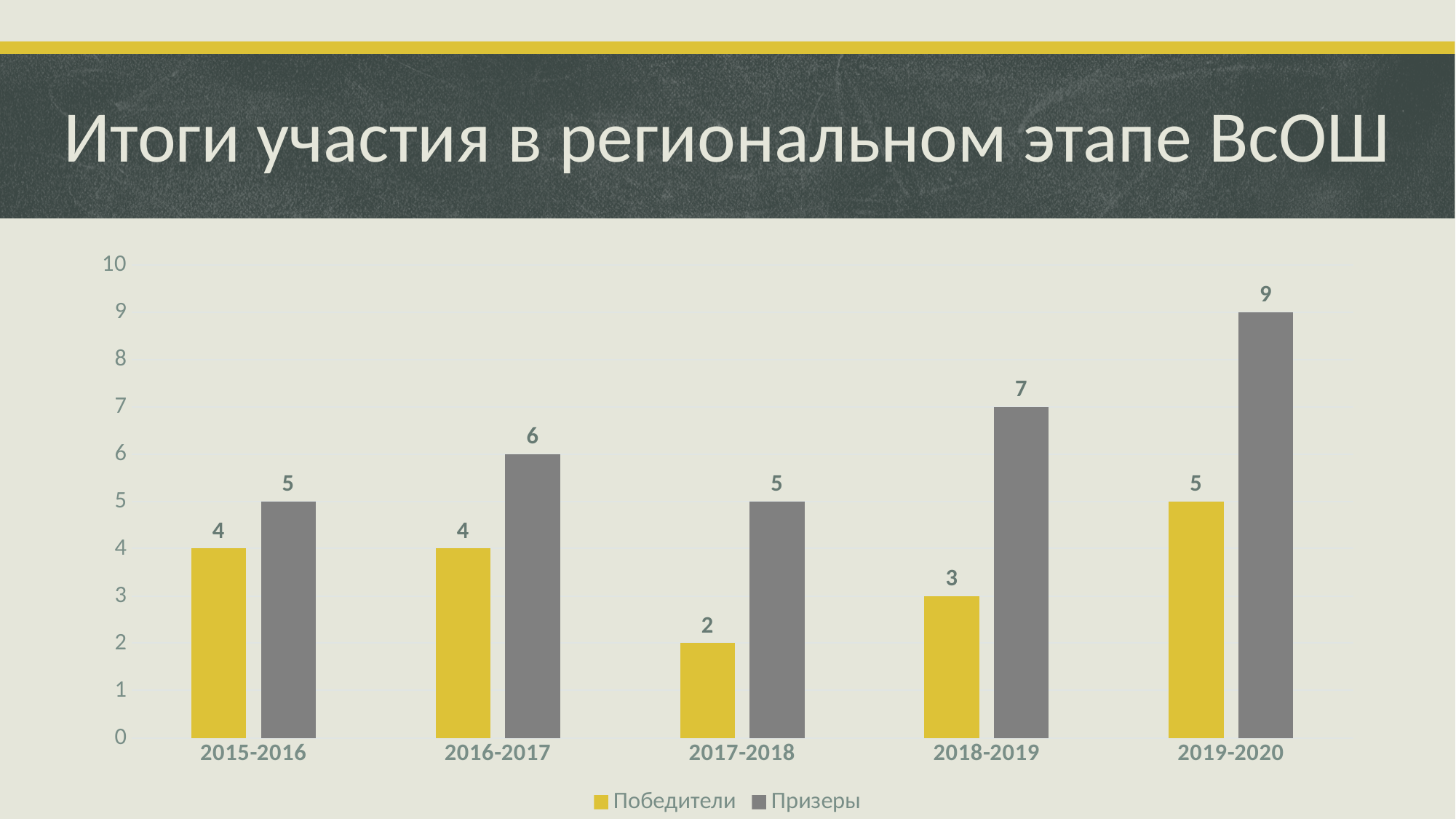
What kind of chart is shown on the slide? Bar chart Which is larger in 2015-2016: Победители or Призеры? Призеры What is the value for Победители in 2017-2018? 2 What is the value for Призеры in 2016-2017? 6 Which year has the lowest value for Победители? 2017-2018 How many series does the legend list? 2 What colour are the bars for Победители? Yellow How many year categories are shown on the x axis? 5 Which year has the highest value for Призеры? 2019-2020 What is the value for Призеры in 2019-2020? 9 Does the value for Призеры rise or fall from 2017-2018 to 2019-2020? Rise What is the difference between Призеры and Победители in 2018-2019? 4